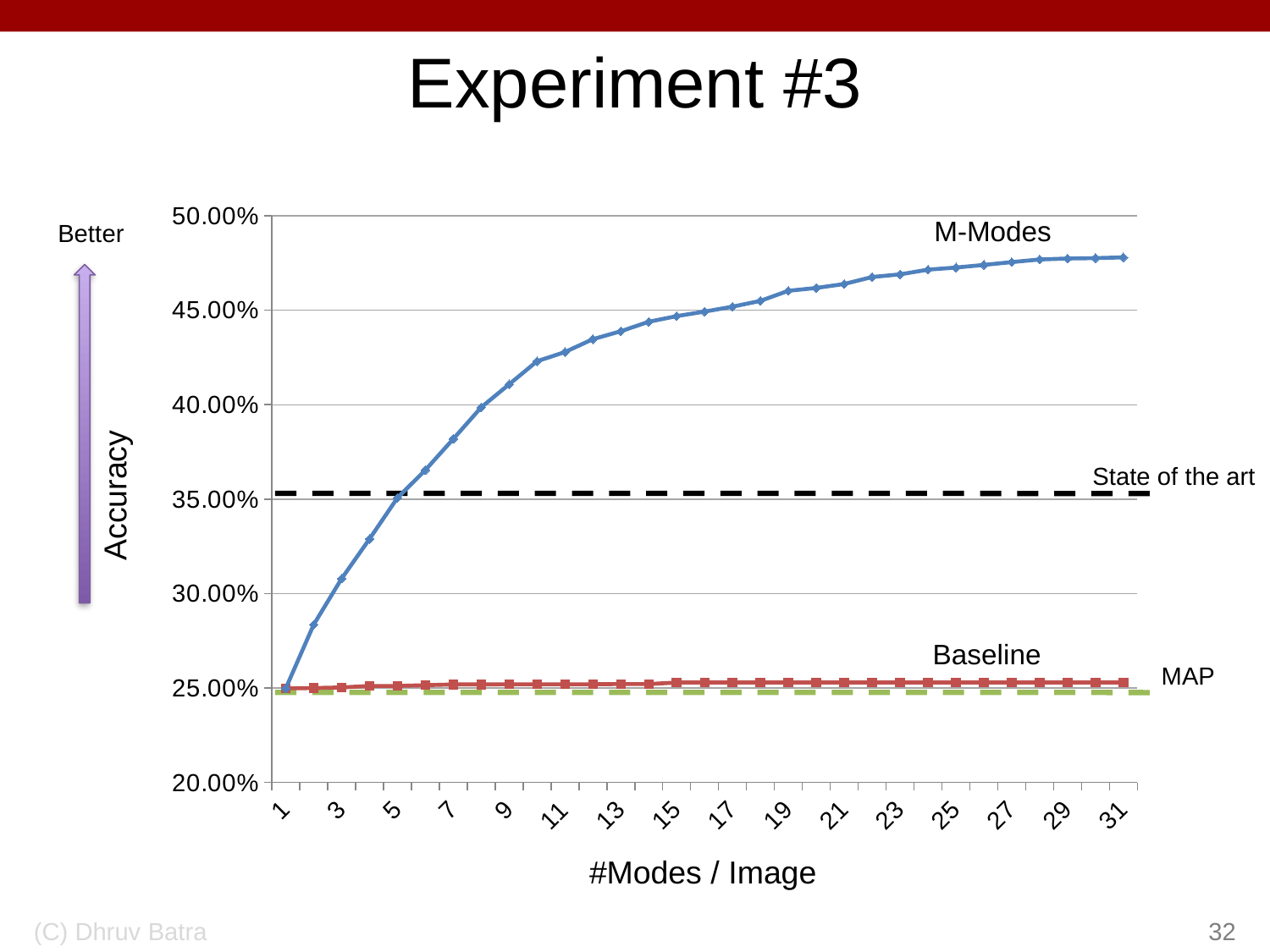
Is the Baseline accuracy at 31 modes per image greater or less than 30.00%? less What is the label of the y axis of the chart? Accuracy Is the M-Modes accuracy at 3 modes per image greater or less than 35.00%? less Is the M-Modes accuracy at 31 modes per image greater or less than 45.00%? greater Which series reaches the highest accuracy on the chart? M-Modes How does the M-Modes accuracy change as #Modes / Image increases from 1 to 31? rises At 31 modes per image, which has higher accuracy: M-Modes or Baseline? M-Modes What kind of chart is shown on the slide? line chart What is the label of the x axis of the chart? #Modes / Image Which series has the lowest accuracy on the chart? MAP